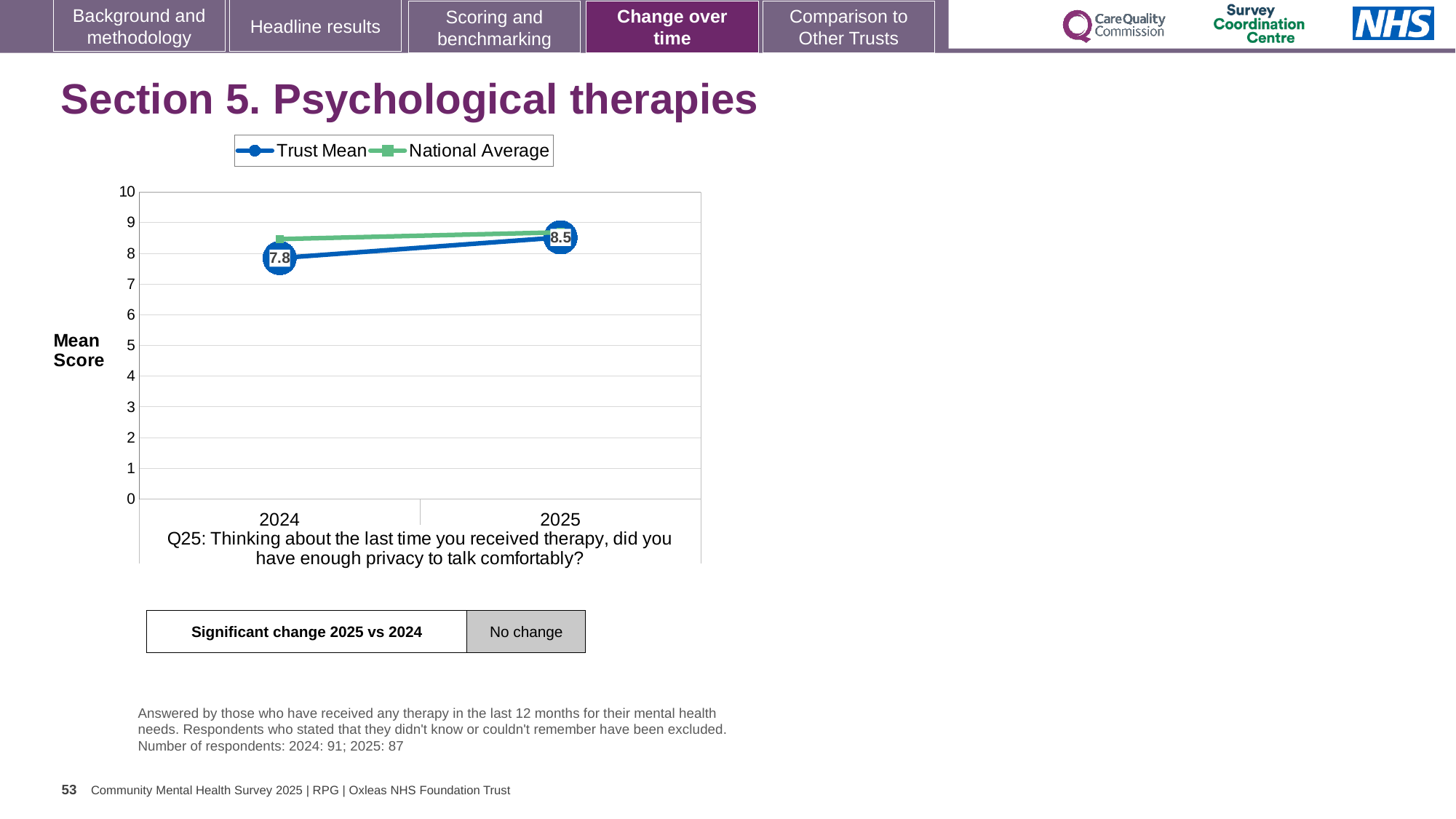
What is the Trust Mean score for 2025? 8.5 Is the National Average value for 2024 greater or less than 8? greater How many series does the legend list? 2 What is the Trust Mean score for 2024? 7.8 In which year is the Trust Mean score lower? 2024 Is the National Average value for 2025 greater or less than 9? less What kind of chart is shown on the slide? Line chart Which is larger in 2024: the Trust Mean or the National Average? National Average By how much did the Trust Mean score change from 2024 to 2025? 0.7 Does the Trust Mean rise or fall from 2024 to 2025? Rise How many years are plotted on the x axis? 2 In which year is the Trust Mean score higher? 2025